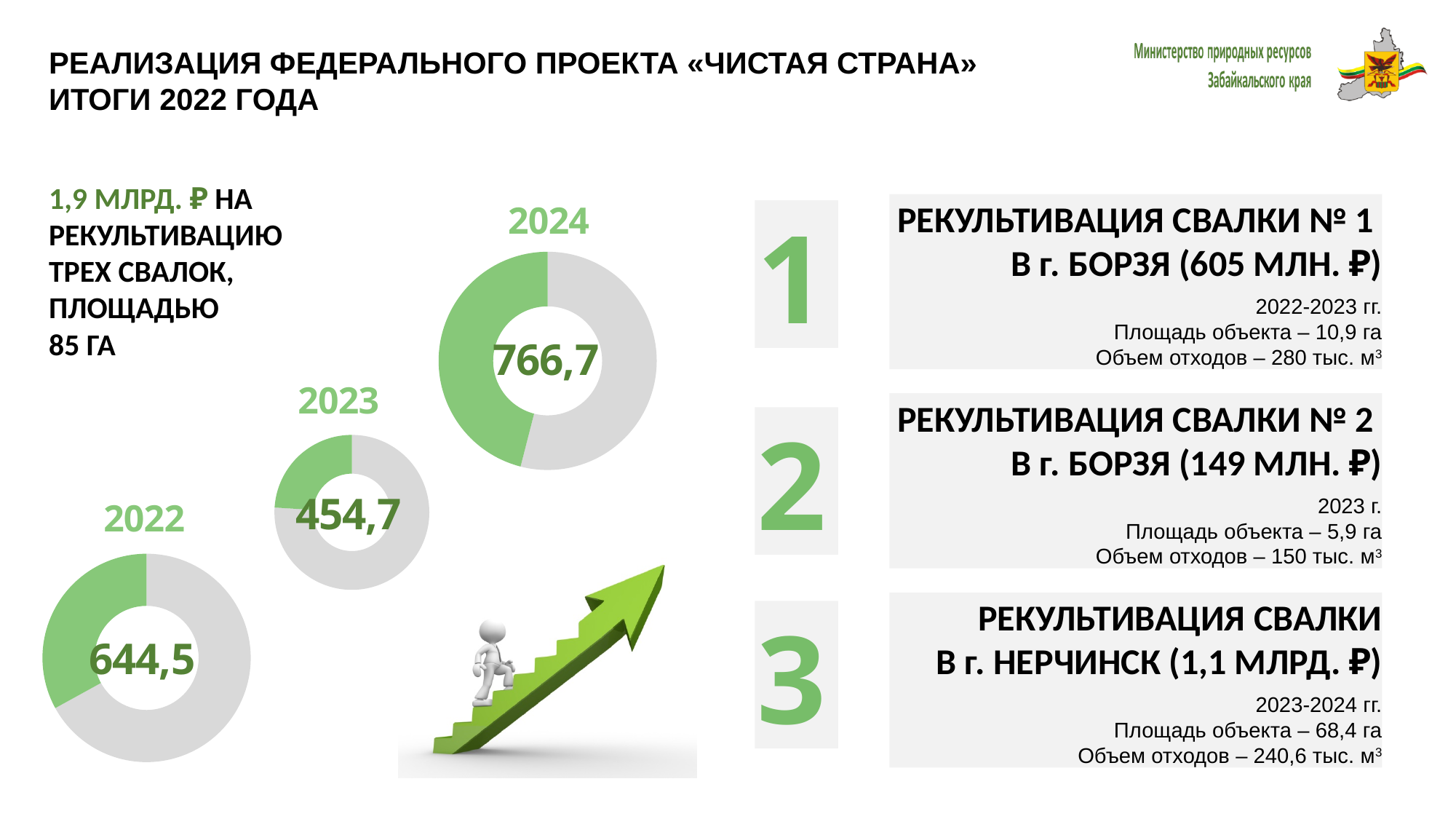
Do the values shown in the donut charts rise steadily from 2022 to 2024? No, they fall in 2023 and then rise in 2024 What value is shown in the donut chart labelled 2023? 454,7 What kind of chart is used to show the values for 2022, 2023 and 2024? Donut chart What colour is the filled portion of each donut chart? Green What is the difference between the values shown for 2024 and 2022? 122,2 Which year's donut chart shows the lowest value? 2023 What value is shown in the donut chart labelled 2022? 644,5 What is the difference between the values shown for 2022 and 2023? 189,8 What value is shown in the donut chart labelled 2024? 766,7 Which is larger, the value for 2022 or the value for 2023? 2022 How many donut charts are shown on the slide? 3 Which year's donut chart shows the highest value? 2024